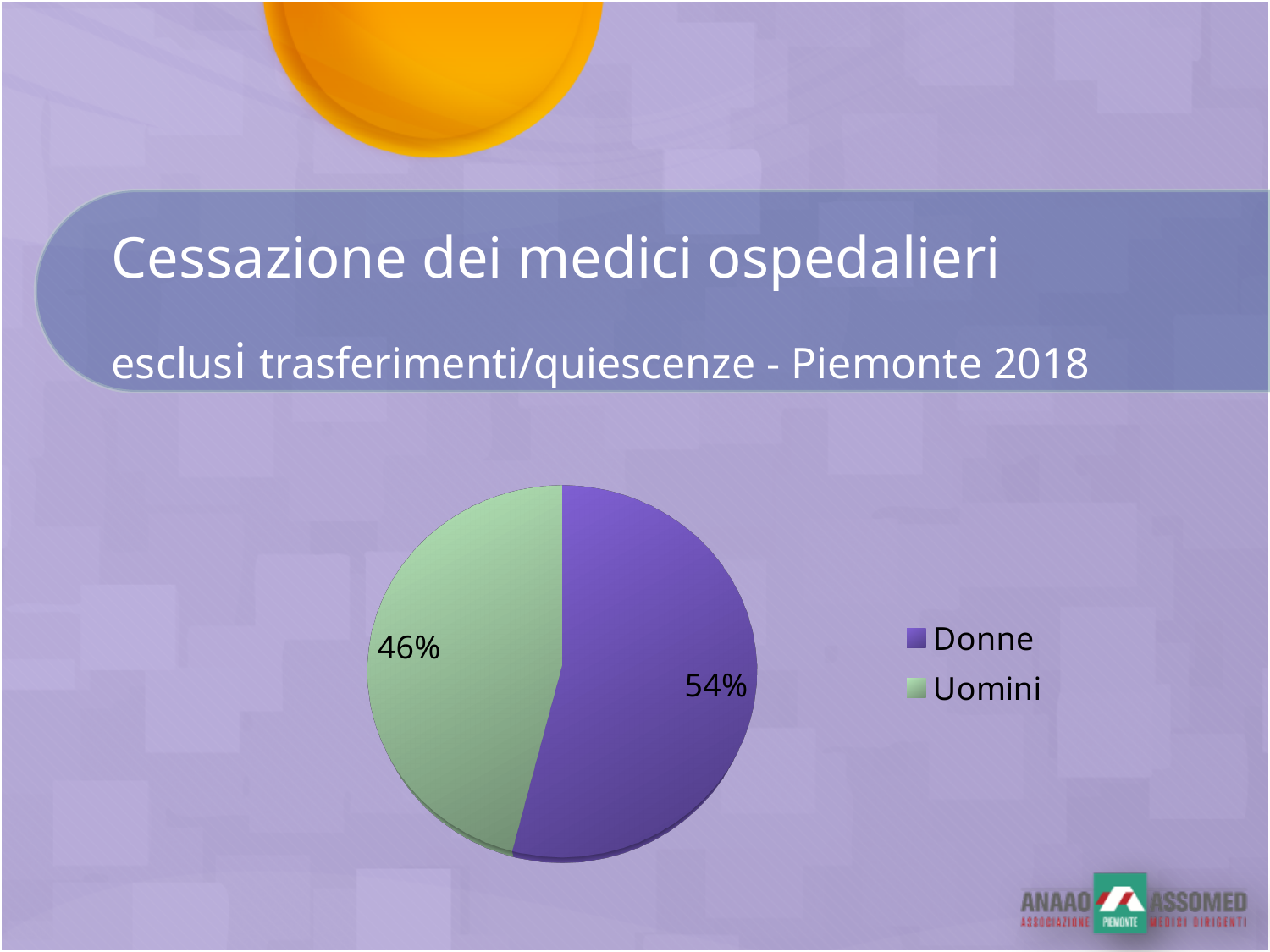
What share of the pie does Uomini represent? 46% How many slices does the pie chart have? 2 Which category has the smallest slice of the pie? Uomini Which category has the largest slice of the pie? Donne What is the difference in percentage points between the Donne and Uomini slices? 8 What colour is the Donne slice? Purple What colour is the Uomini slice? Green What share of the pie does Donne represent? 54% What kind of chart is shown on the slide? Pie chart Is the share for Donne greater or less than 50%? greater How many entries does the legend list? 2 Which slice is larger, Donne or Uomini? Donne